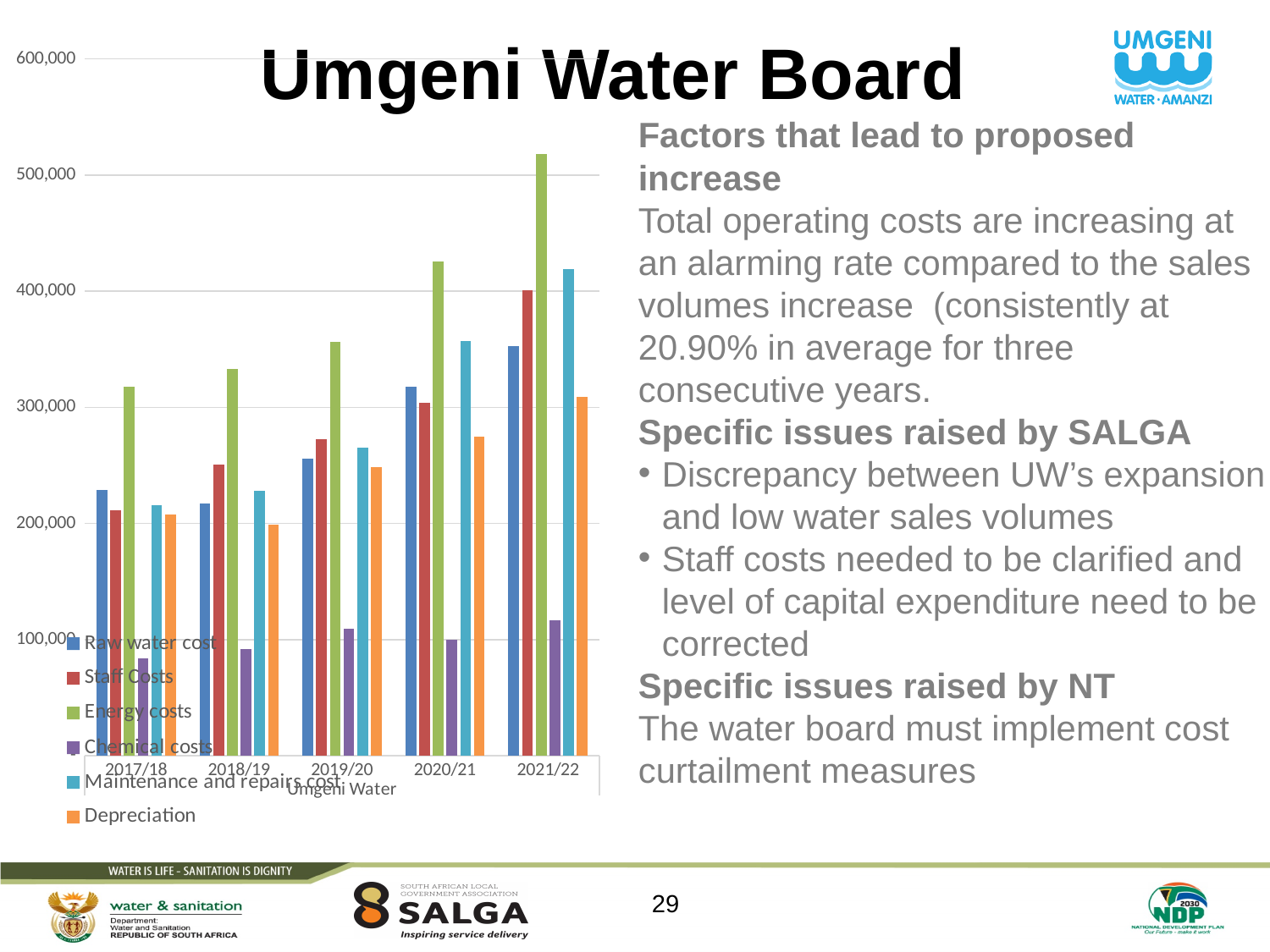
What label appears under the x axis of the chart? Umgeni Water Do Energy costs rise or fall from 2017/18 to 2021/22? rise What kind of chart is shown on the slide? bar chart How many financial years are shown on the x axis of the chart? 5 Is the value for Chemical costs in 2018/19 greater or less than 100,000? less Is the value for Energy costs in 2021/22 greater or less than 500,000? greater Which cost series has the lowest value in 2021/22? Chemical costs Which is larger in 2020/21, Staff Costs or Depreciation? Staff Costs Which cost series has the highest value in 2021/22? Energy costs How many series does the chart's legend list? 6 In which year are Energy costs the highest? 2021/22 Is the value for Maintenance and repairs cost in 2021/22 greater or less than 400,000? greater